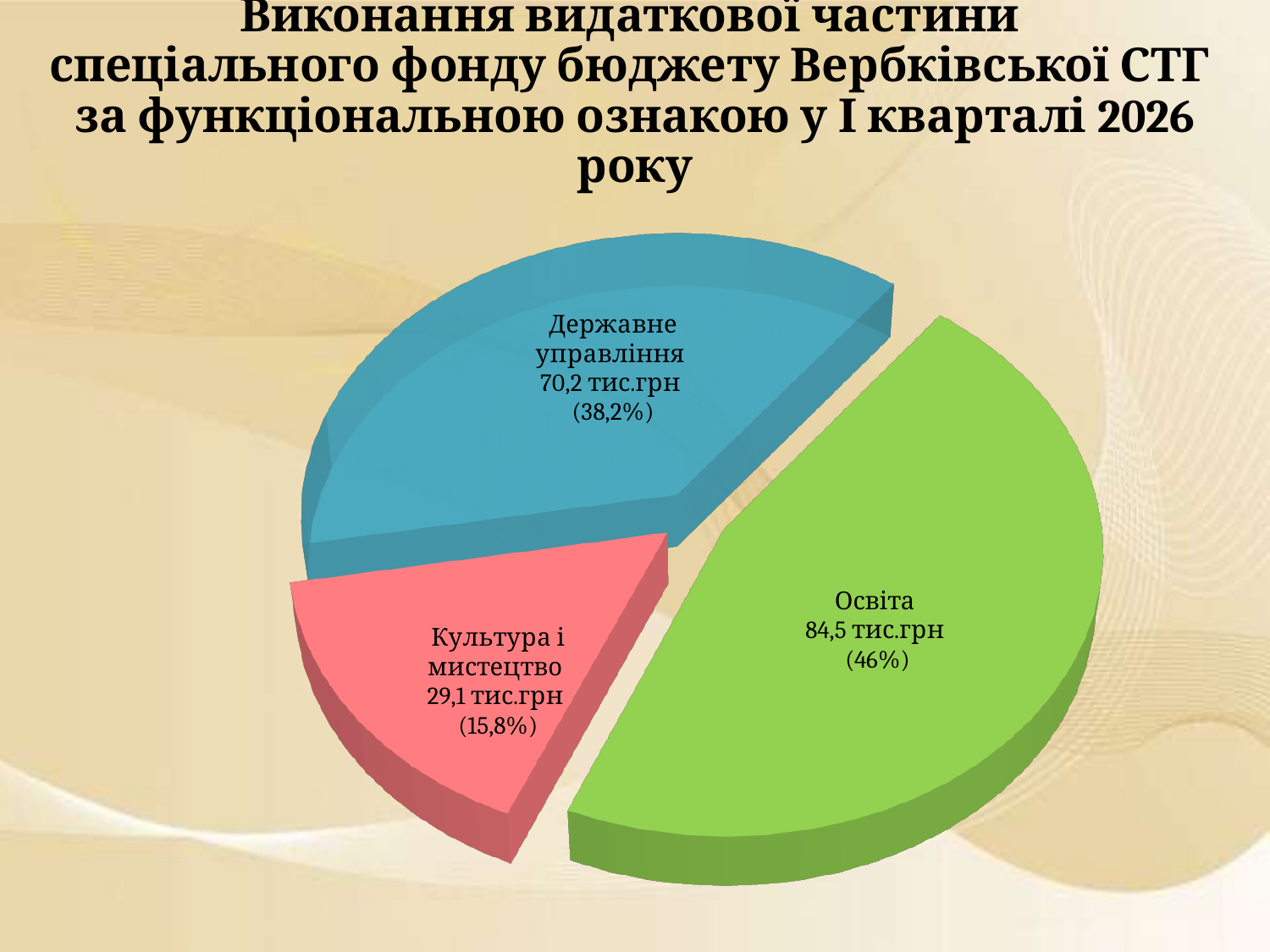
What share of the pie does Державне управління represent? 38,2% Which category has the smallest slice of the pie? Культура і мистецтво What is the difference between the values for Освіта and Державне управління? 14,3 тис.грн What share of the pie does Культура і мистецтво represent? 15,8% What kind of chart is shown on the slide? pie chart Which is larger, the value for Державне управління or the value for Культура і мистецтво? Державне управління What is the value for Державне управління? 70,2 тис.грн Which category has the largest slice of the pie? Освіта How many slices does the pie chart have? 3 What is the value for Освіта? 84,5 тис.грн What colour is the slice for Освіта? green What is the value for Культура і мистецтво? 29,1 тис.грн